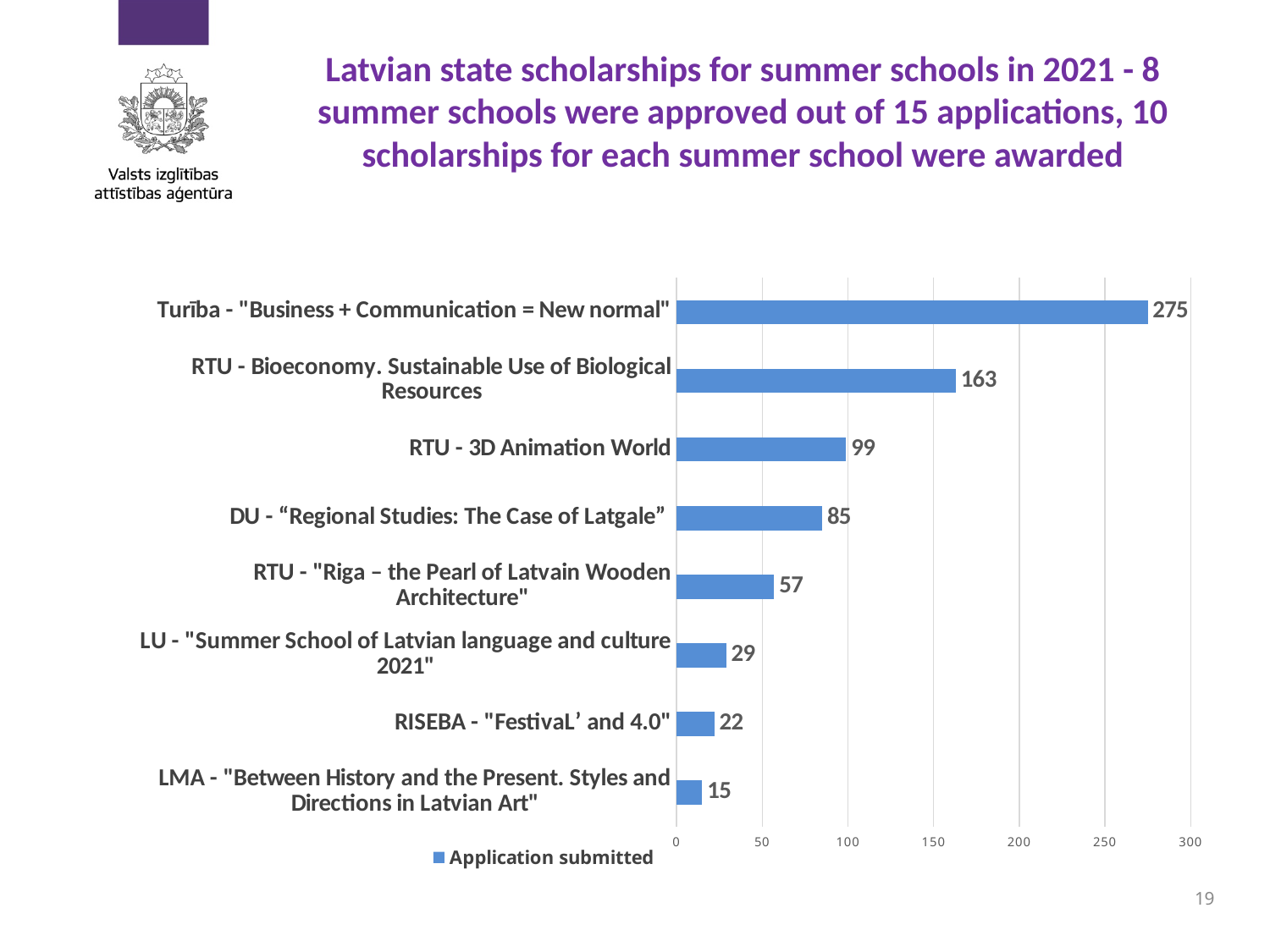
What is the legend entry of the chart? Application submitted Which summer school has the lowest number of applications submitted? LMA - "Between History and the Present. Styles and Directions in Latvian Art" Which has more applications submitted: DU - "Regional Studies: The Case of Latgale" or RTU - "Riga – the Pearl of Latvain Wooden Architecture"? DU - "Regional Studies: The Case of Latgale" What is the difference in applications submitted between Turība - "Business + Communication = New normal" and RTU - Bioeconomy. Sustainable Use of Biological Resources? 112 Is the value for RTU - Bioeconomy. Sustainable Use of Biological Resources greater or less than 150? greater What is the value for RTU - 3D Animation World? 99 What kind of chart is shown on the slide? bar chart How many series does the legend list? 1 Which summer school has the highest number of applications submitted? Turība - "Business + Communication = New normal" How many applications were submitted for LU - "Summer School of Latvian language and culture 2021"? 29 How many applications were submitted for Turība - "Business + Communication = New normal"? 275 How many summer schools are shown in the chart? 8